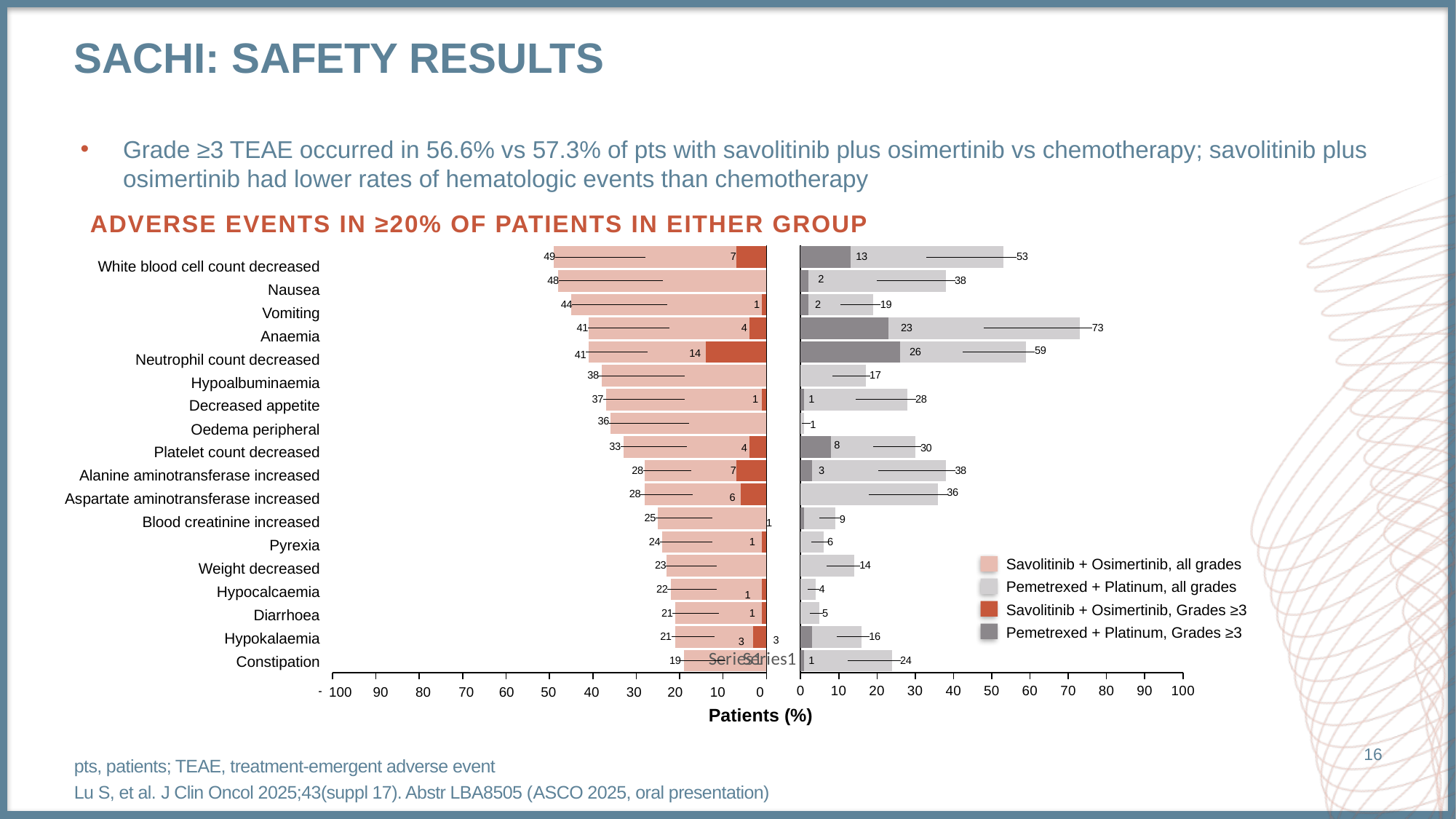
What is the difference between the all-grades rates of nausea in the Savolitinib + Osimertinib group and the Pemetrexed + Platinum group? 10 How many adverse event categories are listed on the chart? 18 Which adverse event has the lowest all-grades rate in the Pemetrexed + Platinum group? Oedema peripheral Which adverse event has the highest all-grades rate in the Pemetrexed + Platinum group? Anaemia Which group has the higher all-grades rate of vomiting, Savolitinib + Osimertinib or Pemetrexed + Platinum? Savolitinib + Osimertinib What is the all-grades rate of white blood cell count decreased in the Savolitinib + Osimertinib group? 49 What is the Grades ≥3 rate of neutrophil count decreased in the Pemetrexed + Platinum group? 26 What is the label of the x axis? Patients (%) What type of chart is shown on the slide? bar chart What is the all-grades rate of anaemia in the Pemetrexed + Platinum group? 73 How many series does the chart legend list? 4 What is the Grades ≥3 rate of neutrophil count decreased in the Savolitinib + Osimertinib group? 14